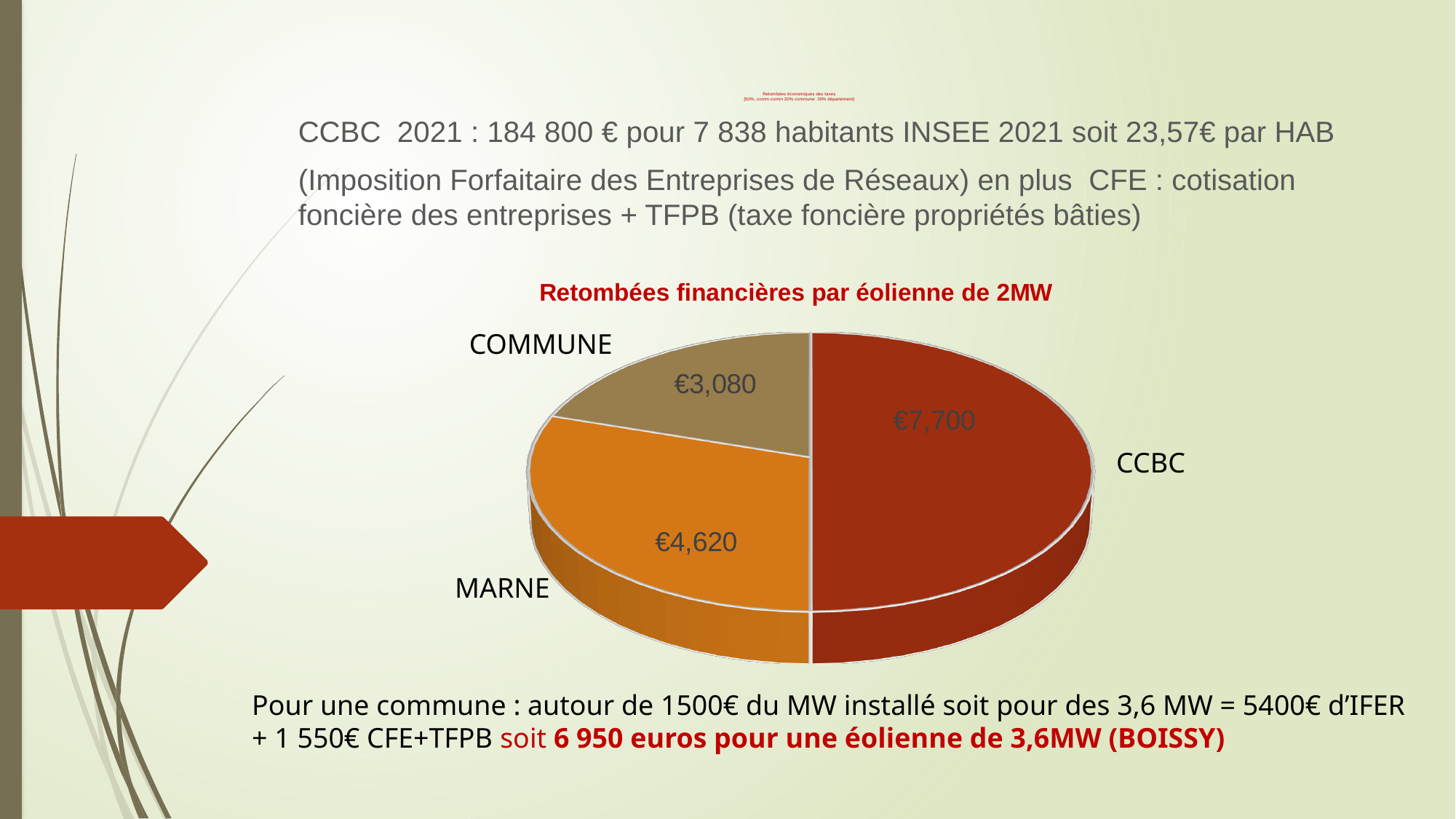
What type of chart is shown on the slide? Pie chart How many slices does the pie chart have? 3 What is the value of the CCBC slice in the pie chart? €7,700 What is the value of the MARNE slice in the pie chart? €4,620 Which category has the largest slice in the pie chart? CCBC Which is larger in the pie chart, the MARNE slice or the COMMUNE slice? MARNE What is the difference between the MARNE and COMMUNE values in the pie chart? €1,540 What is the value of the COMMUNE slice in the pie chart? €3,080 What is the title of the pie chart? Retombées financières par éolienne de 2MW Which category has the smallest slice in the pie chart? COMMUNE What is the difference between the CCBC and MARNE values in the pie chart? €3,080 What share of the pie chart total does the CCBC slice represent? 50%